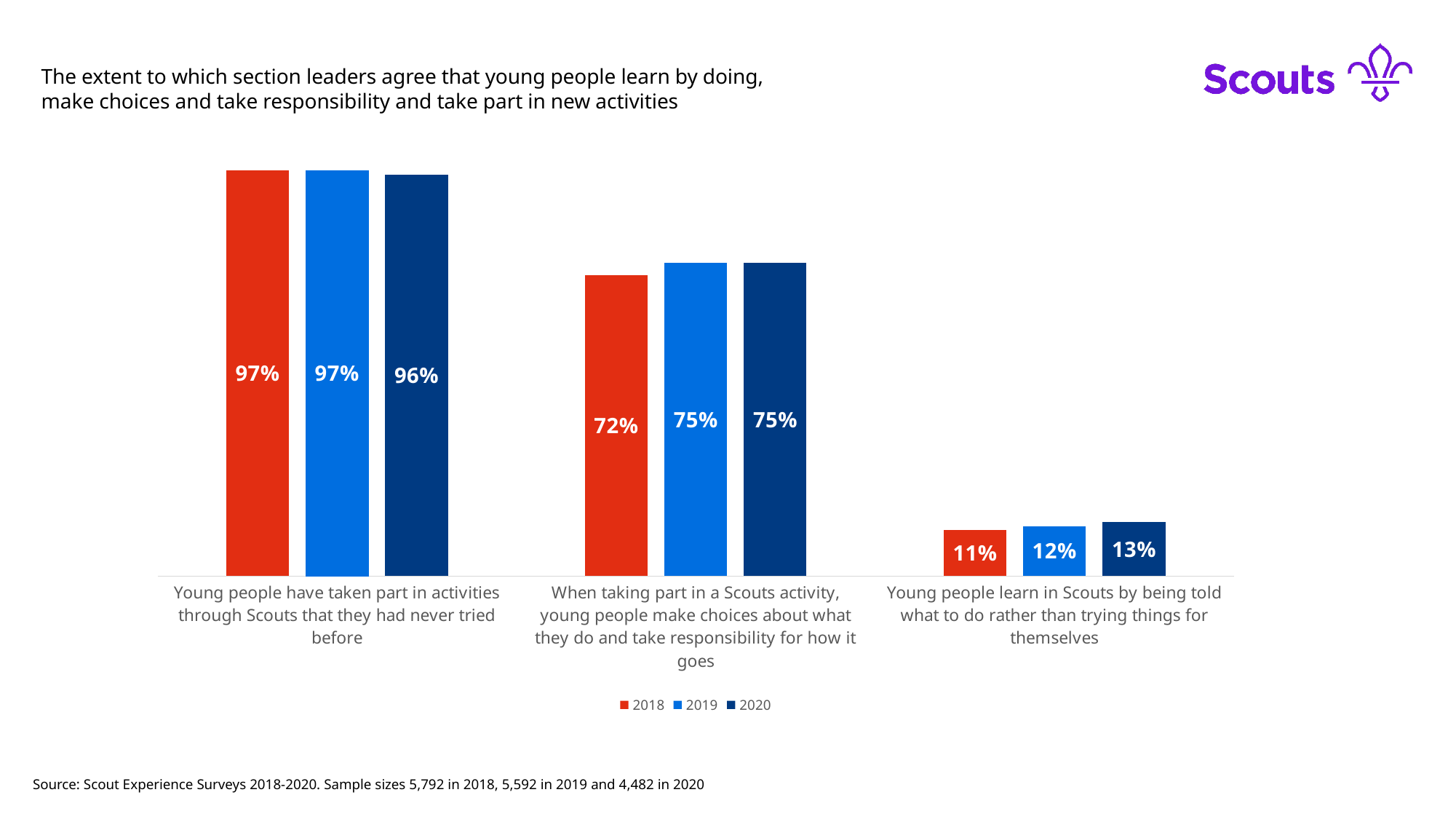
What kind of chart is shown on the slide? Bar chart Do the values for 'Young people learn in Scouts by being told what to do rather than trying things for themselves' rise or fall from 2018 to 2020? Rise How many categories are shown on the x axis? 3 Which category has the highest 2020 value? Young people have taken part in activities through Scouts that they had never tried before Which category has the lowest 2018 value? Young people learn in Scouts by being told what to do rather than trying things for themselves Which year does the red series in the legend represent? 2018 What is the 2019 value for 'Young people learn in Scouts by being told what to do rather than trying things for themselves'? 12% How many series does the legend list? 3 Which is larger for 'Young people learn in Scouts by being told what to do rather than trying things for themselves': the 2018 value or the 2020 value? 2020 What is the difference between the 2019 and 2018 values for 'When taking part in a Scouts activity, young people make choices about what they do and take responsibility for how it goes'? 3% What is the 2018 value for 'Young people have taken part in activities through Scouts that they had never tried before'? 97% What is the 2020 value for 'When taking part in a Scouts activity, young people make choices about what they do and take responsibility for how it goes'? 75%